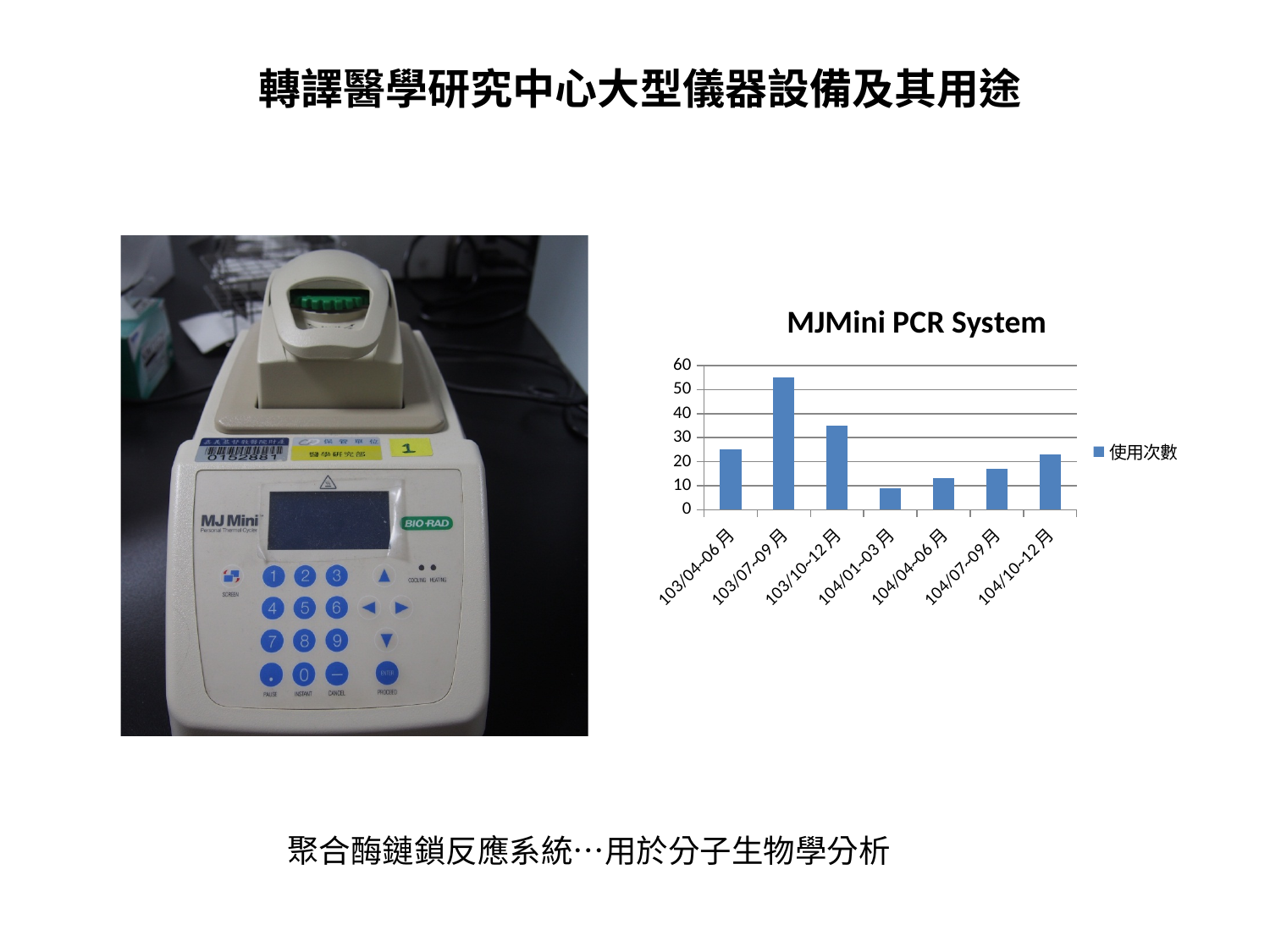
How many categories are shown on the x axis of the MJMini PCR System chart? 7 Which period has the lowest value in the MJMini PCR System chart? 104/01-03月 In the MJMini PCR System chart, which is larger: the value for 103/10-12月 or the value for 103/04-06月? 103/10-12月 In the MJMini PCR System chart, is the value for 103/07-09月 greater or less than 50? greater In the MJMini PCR System chart, is the value for 103/04-06月 greater or less than 30? less In the MJMini PCR System chart, is the value for 104/10-12月 greater or less than 30? less Which period has the highest value in the MJMini PCR System chart? 103/07-09月 How many series does the legend of the MJMini PCR System chart list? 1 What is the legend entry of the MJMini PCR System chart? 使用次數 What is the title of the chart on the slide? MJMini PCR System What type of chart is shown under the title "MJMini PCR System"? bar chart In the MJMini PCR System chart, do the values rise or fall from 104/01-03月 to 104/10-12月? rise